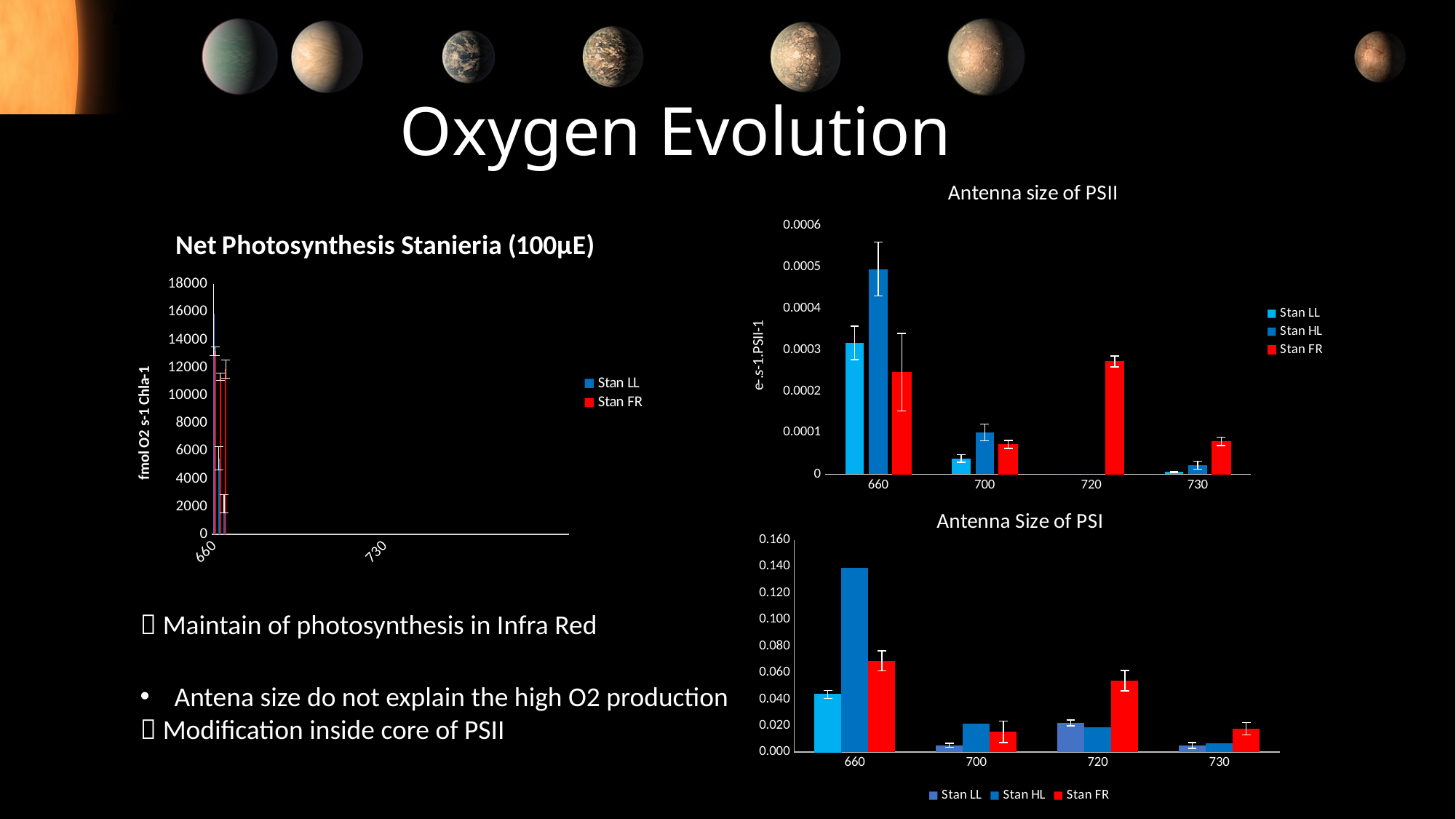
In the Antenna Size of PSI chart, is the value for Stan HL at 660 greater or less than 0.120? greater In the Antenna size of PSII chart, which series has a visible bar at 720? Stan FR How many series does the legend of the Antenna size of PSII chart list? 3 In the Antenna size of PSII chart, which series has the highest value at 660? Stan HL What kind of chart is the Net Photosynthesis Stanieria (100μE) chart? bar chart How many categories are shown on the x axis of the Antenna Size of PSI chart? 4 In the Antenna Size of PSI chart, which series has the highest value at 660? Stan HL In the Antenna Size of PSI chart, which is larger at 720: Stan FR or Stan LL? Stan FR In the Net Photosynthesis Stanieria (100μE) chart, is the value for Stan FR at 660 greater or less than 8000? greater In the Antenna Size of PSI chart, is the value for Stan FR at 730 greater or less than 0.040? less